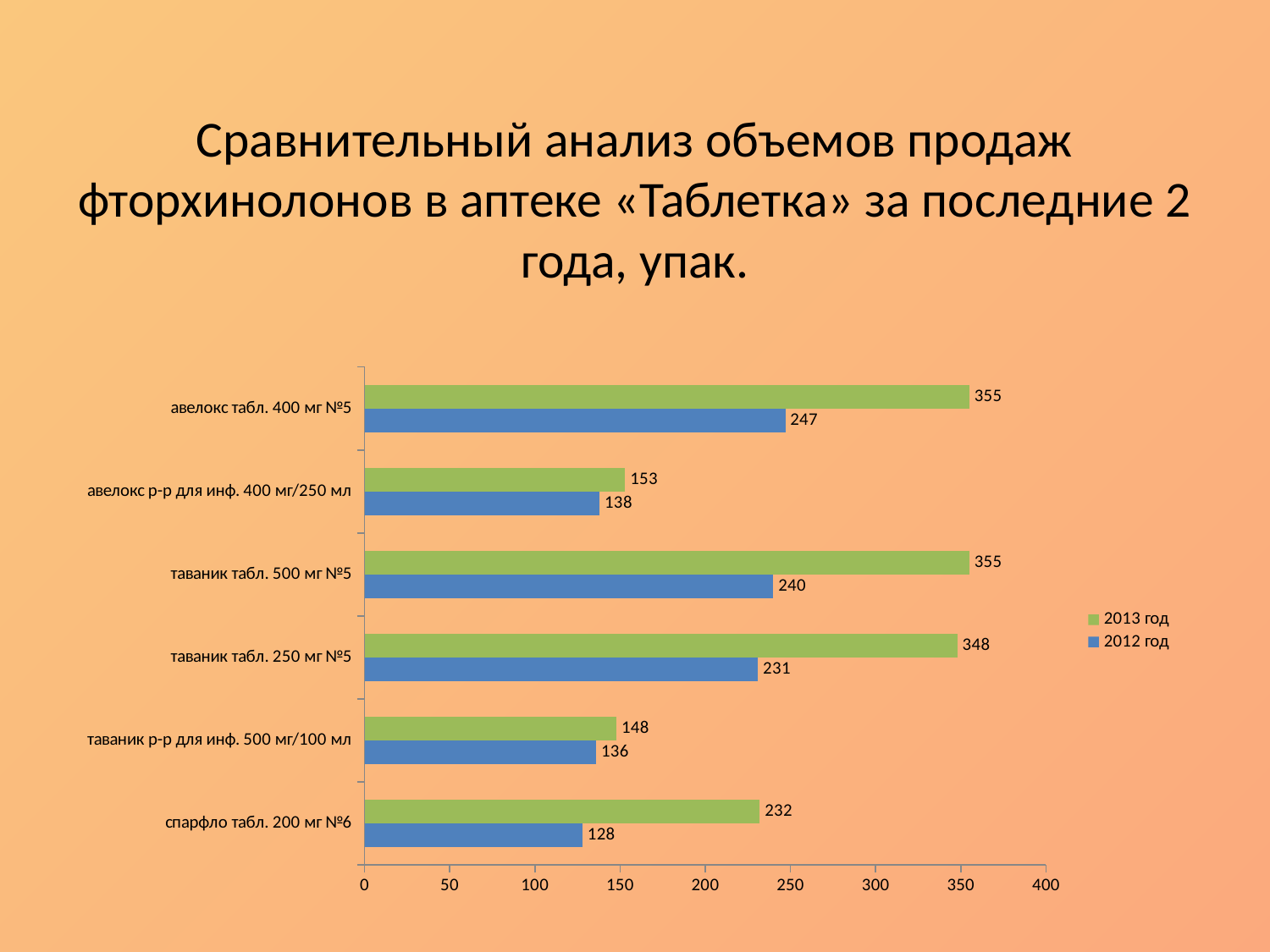
What is the difference between the 2013 год and 2012 год sales volumes for таваник табл. 500 мг №5? 115 How many products are shown on the chart? 6 Which colour represents 2013 год in the chart? green How many series does the legend list? 2 What was the sales volume of авелокс табл. 400 мг №5 in 2013 год? 355 Which is larger: the 2012 год sales of авелокс р-р для инф. 400 мг/250 мл or the 2012 год sales of таваник р-р для инф. 500 мг/100 мл? авелокс р-р для инф. 400 мг/250 мл What is the difference between the 2013 год and 2012 год sales volumes for спарфло табл. 200 мг №6? 104 Which product had the highest sales volume in 2012 год? авелокс табл. 400 мг №5 Which product had the lowest sales volume in 2013 год? таваник р-р для инф. 500 мг/100 мл What type of chart is shown on the slide? bar chart What was the sales volume of таваник табл. 250 мг №5 in 2012 год? 231 What was the sales volume of спарфло табл. 200 мг №6 in 2012 год? 128